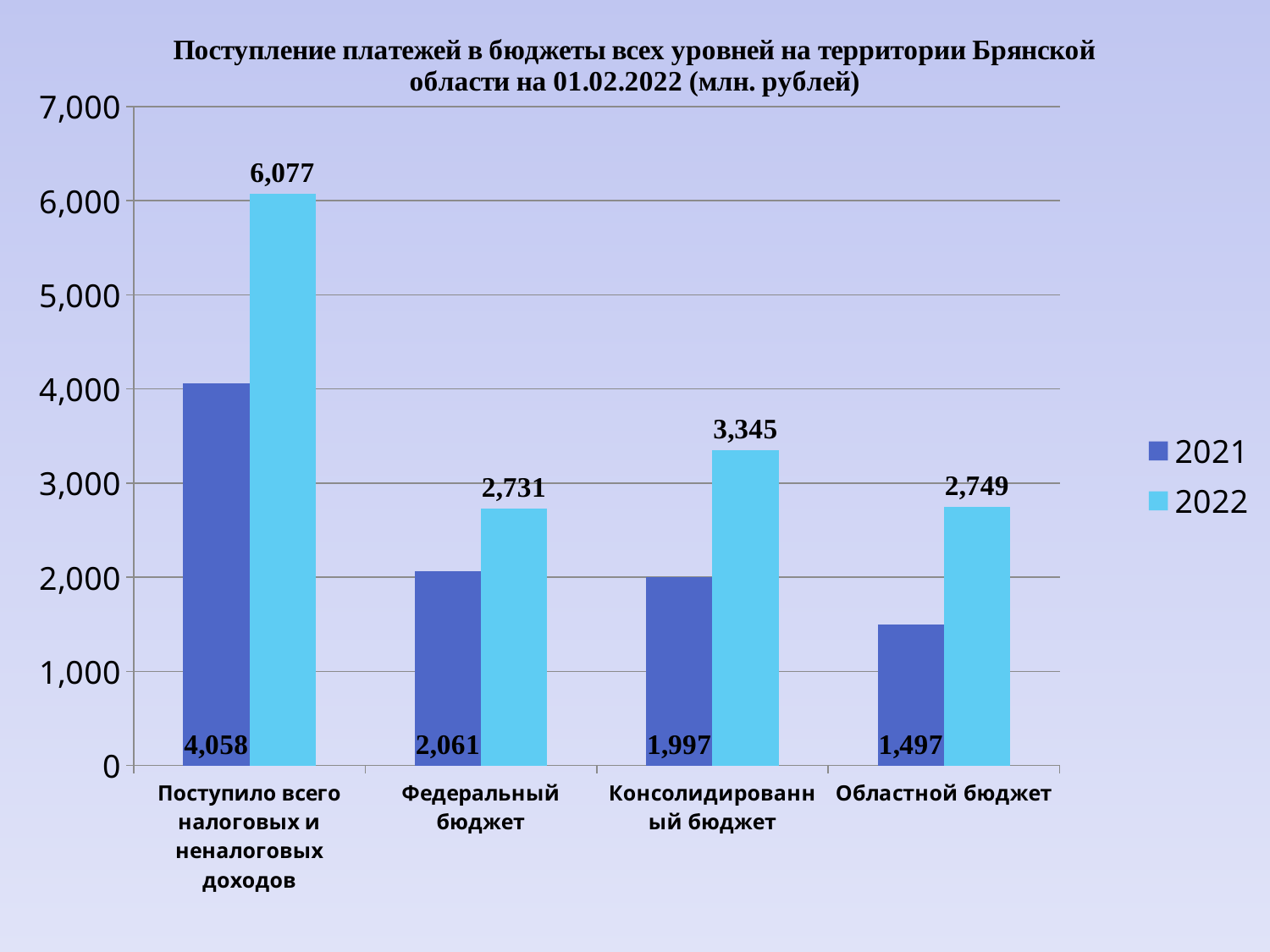
How many series does the legend list? 2 Which colour represents the 2022 series in the legend? light blue Is the 2021 value for Консолидированный бюджет greater or less than 2,000? less Which is larger: the 2022 value for Консолидированный бюджет or the 2022 value for Областной бюджет? Консолидированный бюджет What is the 2021 value for Областной бюджет? 1,497 Which category has the lowest 2021 value? Областной бюджет What is the 2022 value for Консолидированный бюджет? 3,345 Which category has the highest 2022 value? Поступило всего налоговых и неналоговых доходов What is the 2022 value for Федеральный бюджет? 2,731 What kind of chart is shown on the slide? bar chart How many categories are shown on the x axis? 4 What is the difference between the 2022 and 2021 values for Поступило всего налоговых и неналоговых доходов? 2,019